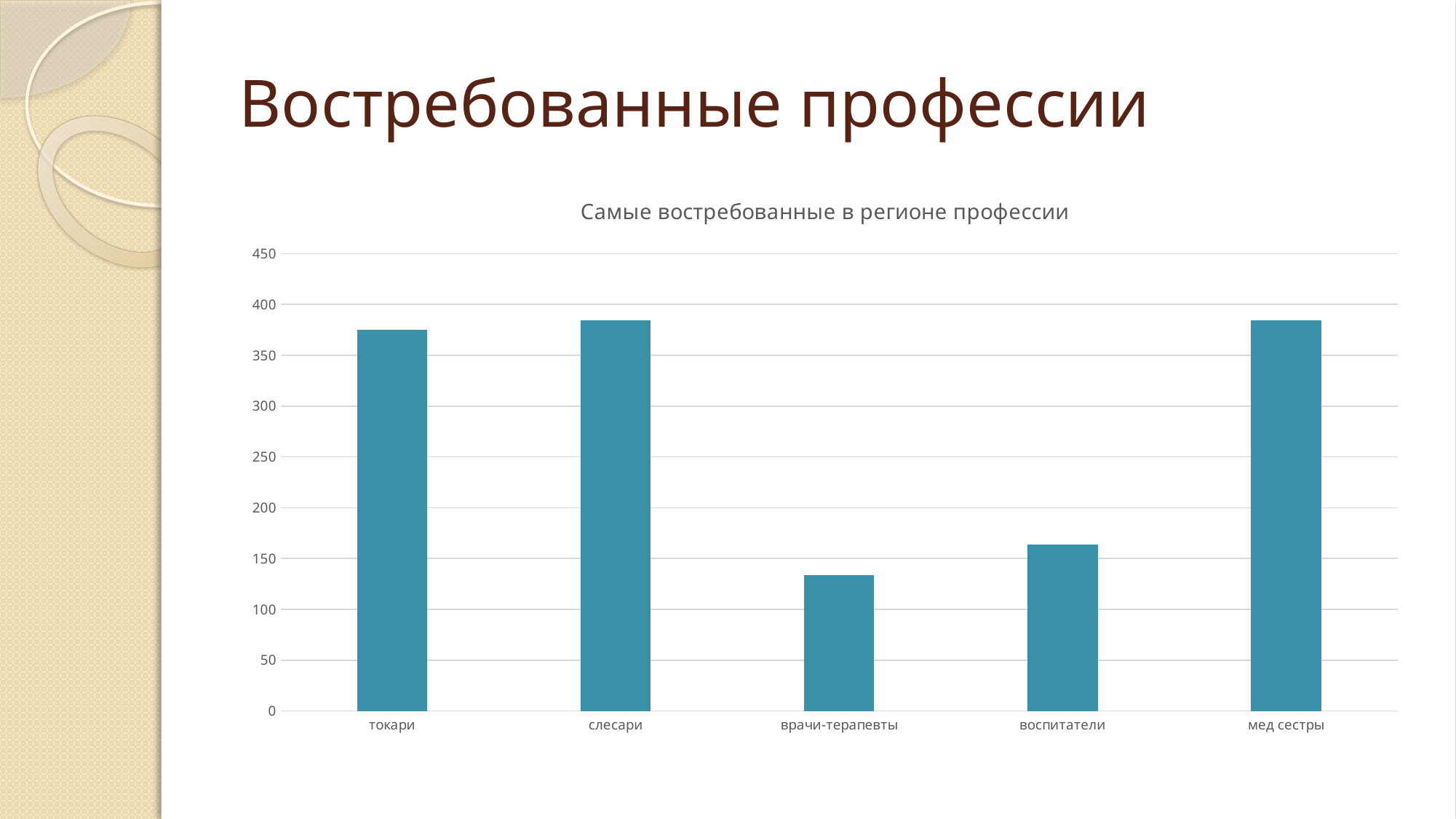
How many professions (categories) are shown on the chart? 5 What kind of chart is shown on the slide? Bar chart What colour are the bars in the chart? Teal (blue-green) Is the value for мед сестры greater or less than 400? less Which profession has the lowest value on the chart? врачи-терапевты Is the value for воспитатели greater or less than 150? greater Which is larger, the value for воспитатели or the value for врачи-терапевты? воспитатели Which is larger, the value for токари or the value for врачи-терапевты? токари Is the value for слесари greater or less than 350? greater What is the title of the chart? Самые востребованные в регионе профессии